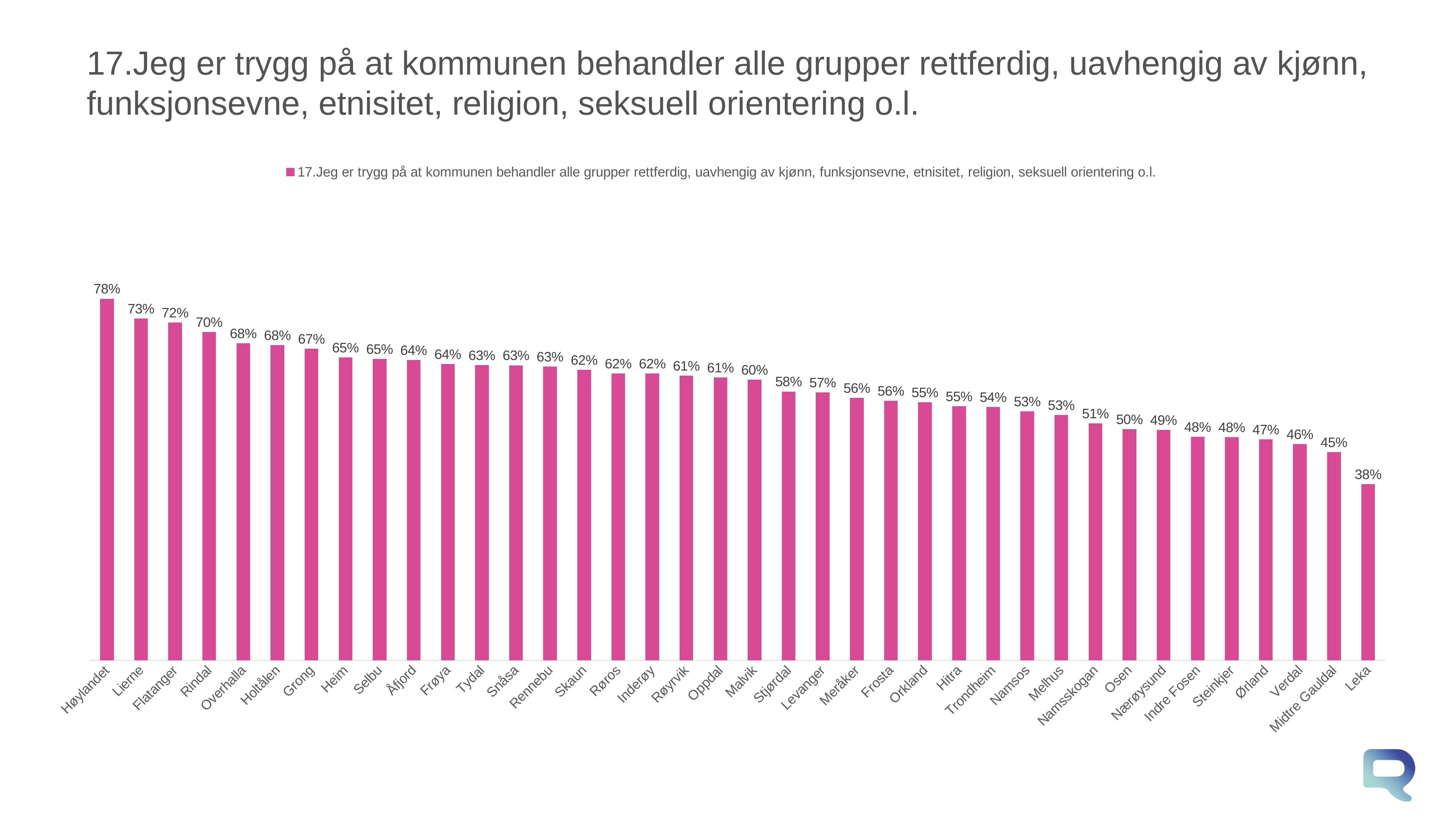
How many municipalities are shown on the chart? 38 What is the value for Stjørdal? 58% Do the values rise or fall from left to right along the x axis? Fall Which has a larger value, Rindal or Namsos? Rindal What is the value for Trondheim? 54% What is the difference between the values for Lierne and Verdal? 27% Which municipality has the highest value? Høylandet What is the value for Leka? 38% What is the difference between the values for Høylandet and Leka? 40% What is the value for Høylandet? 78% What kind of chart is shown on the slide? Bar chart Which municipality has the lowest value? Leka